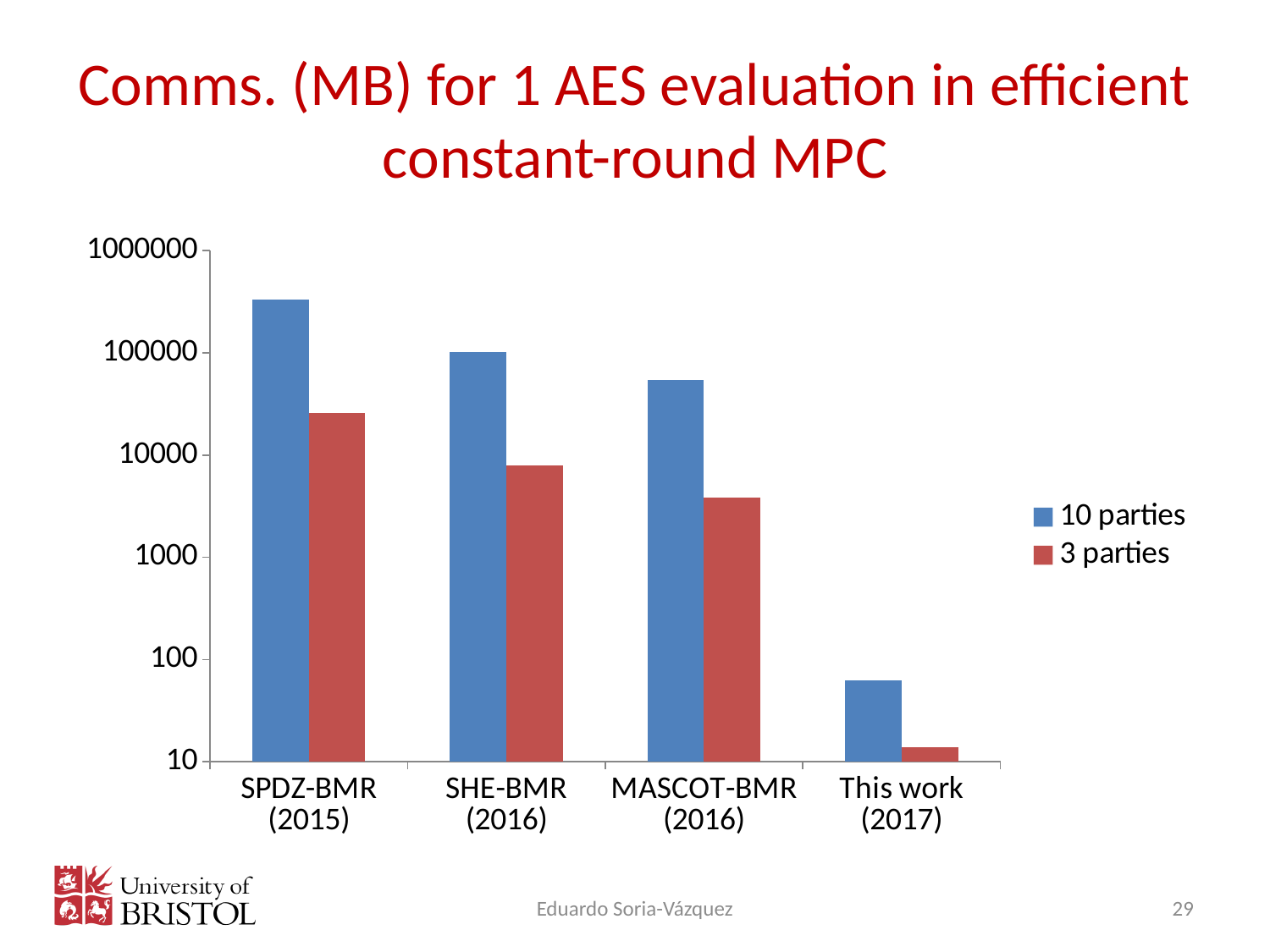
Is the value for SHE-BMR (2016) with 3 parties greater or less than 10000? less How many categories are shown on the x axis? 4 Is the value for This work (2017) with 10 parties greater or less than 100? less Which category has the lowest value for 3 parties? This work (2017) What kind of chart is shown on the slide? bar chart Which is larger for 10 parties: SHE-BMR (2016) or MASCOT-BMR (2016)? SHE-BMR (2016) Is the value for SPDZ-BMR (2015) with 10 parties greater or less than 100000? greater Which colour represents the 3 parties series? red Do the values for 10 parties rise or fall from left to right along the x axis? fall How many series does the legend list? 2 Which category has the highest value for 10 parties? SPDZ-BMR (2015)